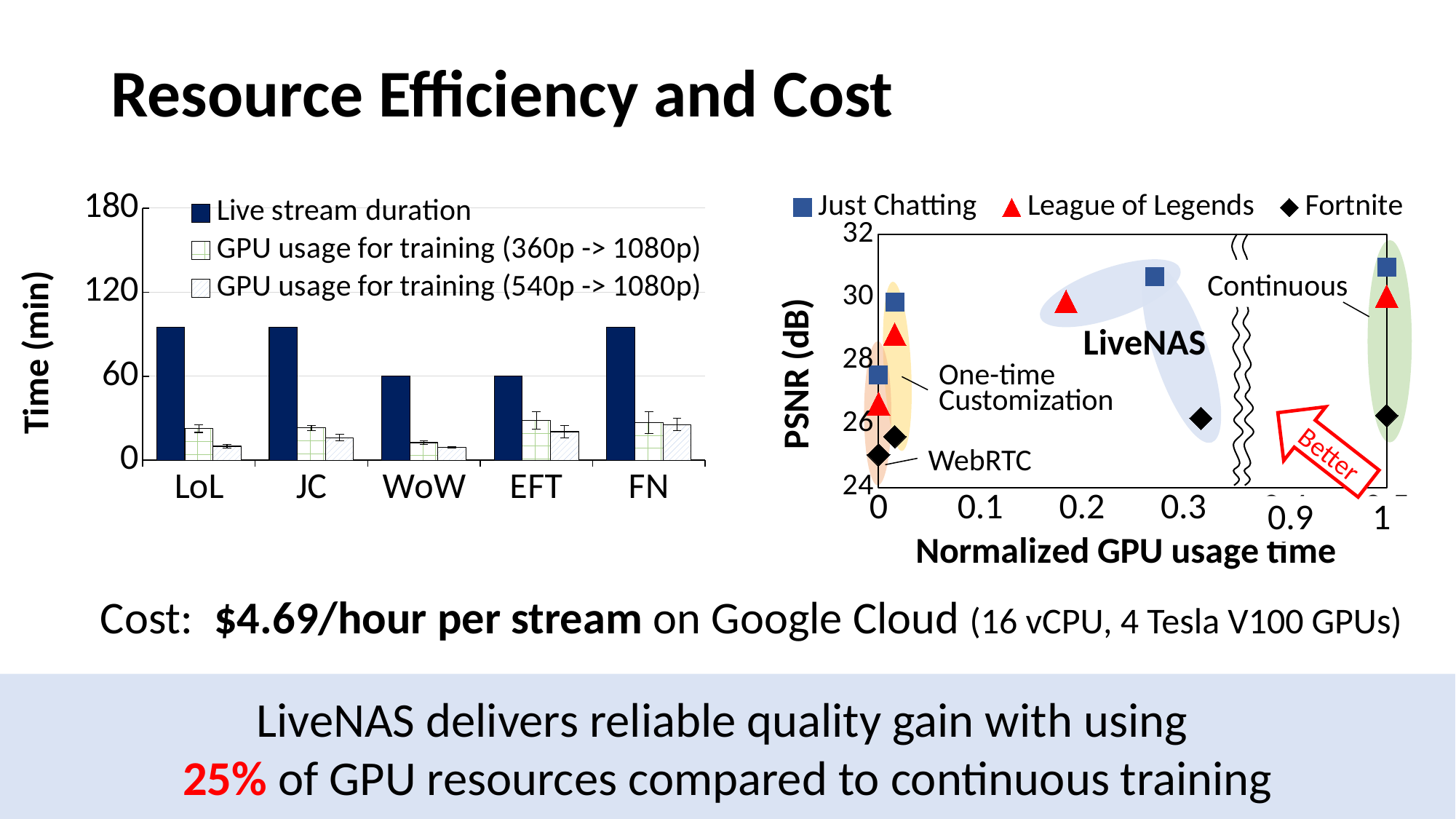
On the left chart, what is the label of the y axis? Time (min) On the left chart, how many series does the legend list? 3 On the right chart, what is the label of the x axis? Normalized GPU usage time On the left chart, is the live stream duration for LoL greater or less than 60 minutes? greater On the right chart, how many series does the legend list? 3 On the left chart, is the live stream duration for WoW greater or less than 120 minutes? less On the right chart, is the PSNR of the Fortnite WebRTC point greater or less than 26 dB? less On the left chart, what kind of chart is it? bar chart On the left chart, how many categories are shown on the x axis? 5 On the left chart, which is larger, the live stream duration for JC or for EFT? JC On the right chart, what kind of chart is it? scatter chart